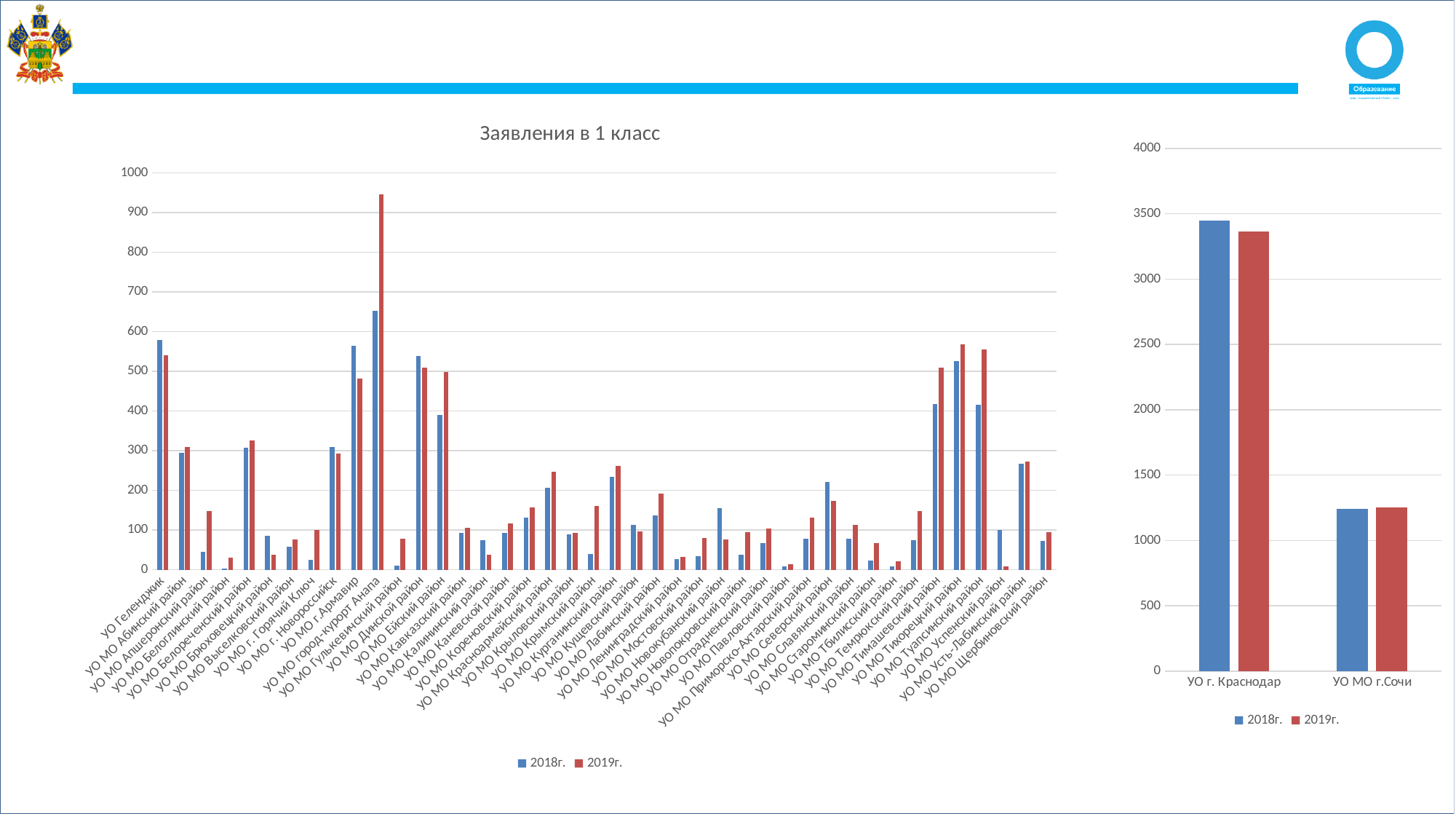
In the chart on the left, is the 2018г. value for УО Геленджик greater or less than 500? greater In the chart on the left, how many series does the legend list? 2 In the chart on the left, for УО МО город-курорт Анапа, which series has the larger value, 2018г. or 2019г.? 2019г. What kind of chart is the chart on the right? bar chart What is the title of the chart on the left? Заявления в 1 класс In the chart on the right, how many categories are shown on the x axis? 2 In the chart on the right, is the 2018г. value for УО г. Краснодар greater or less than 3000? greater In the chart on the right, is the 2019г. value for УО МО г.Сочи greater or less than 1500? less In the chart on the left, for УО Геленджик, which series has the larger value, 2018г. or 2019г.? 2018г. In the chart on the right, for УО г. Краснодар, which series has the larger value, 2018г. or 2019г.? 2018г. In the chart on the left, which category has the highest bar overall? УО МО город-курорт Анапа